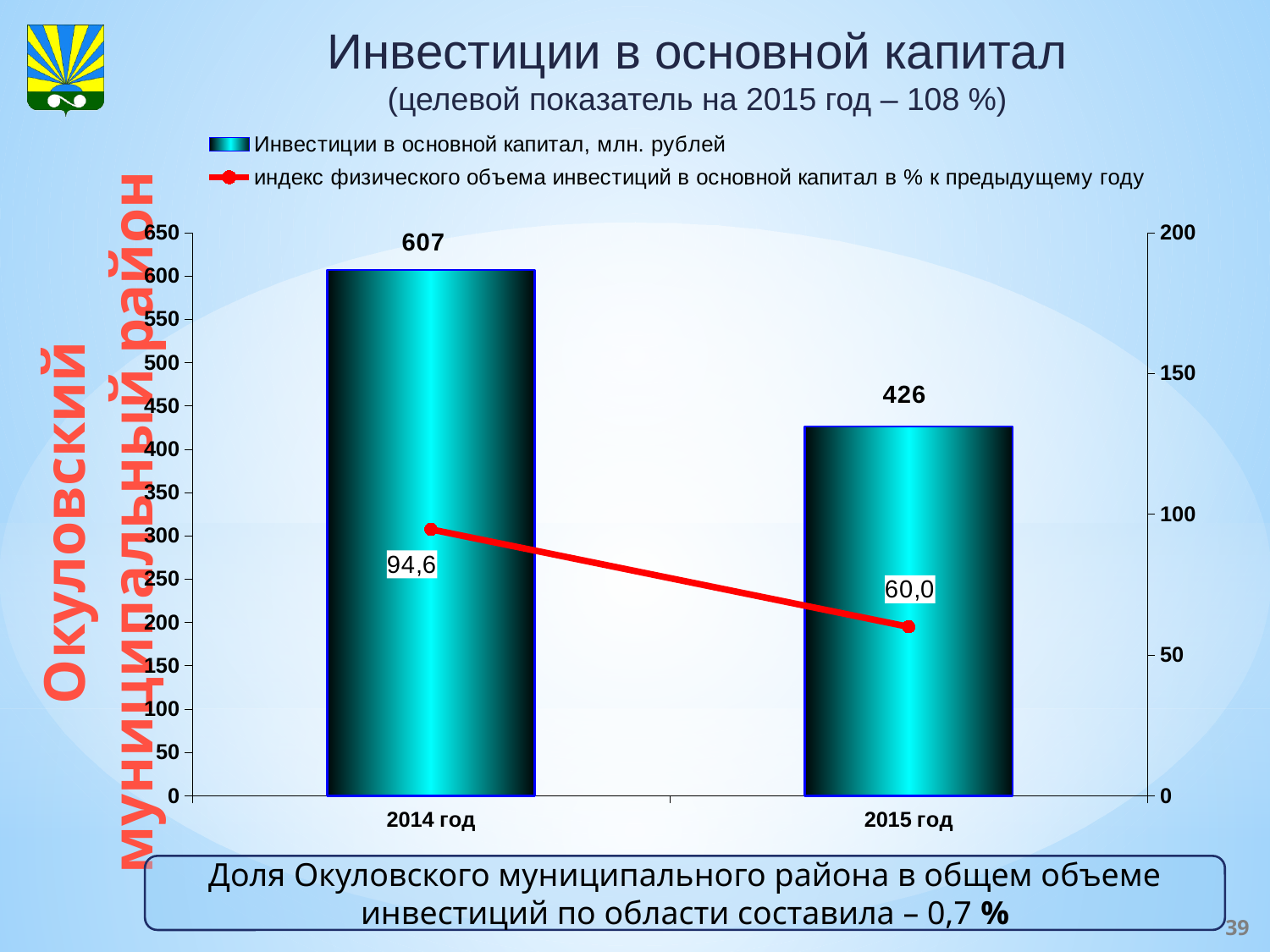
Which year has the lower index of physical volume of investments? 2015 год What colour is the line showing the index of physical volume of investments? red What is the index of physical volume of investments (% to previous year) for 2014 год? 94,6 Do the investment values rise or fall from 2014 год to 2015 год? fall Is the investment value for 2015 год greater or less than 500? less What is the index of physical volume of investments (% to previous year) for 2015 год? 60,0 What is the value of investments in fixed capital (млн. рублей) for 2015 год? 426 Which year has the higher value of investments in fixed capital? 2014 год How many series does the legend list? 2 What is the difference between the investment values for 2014 год and 2015 год? 181 What is the value of investments in fixed capital (млн. рублей) for 2014 год? 607 How many years are shown on the x axis? 2